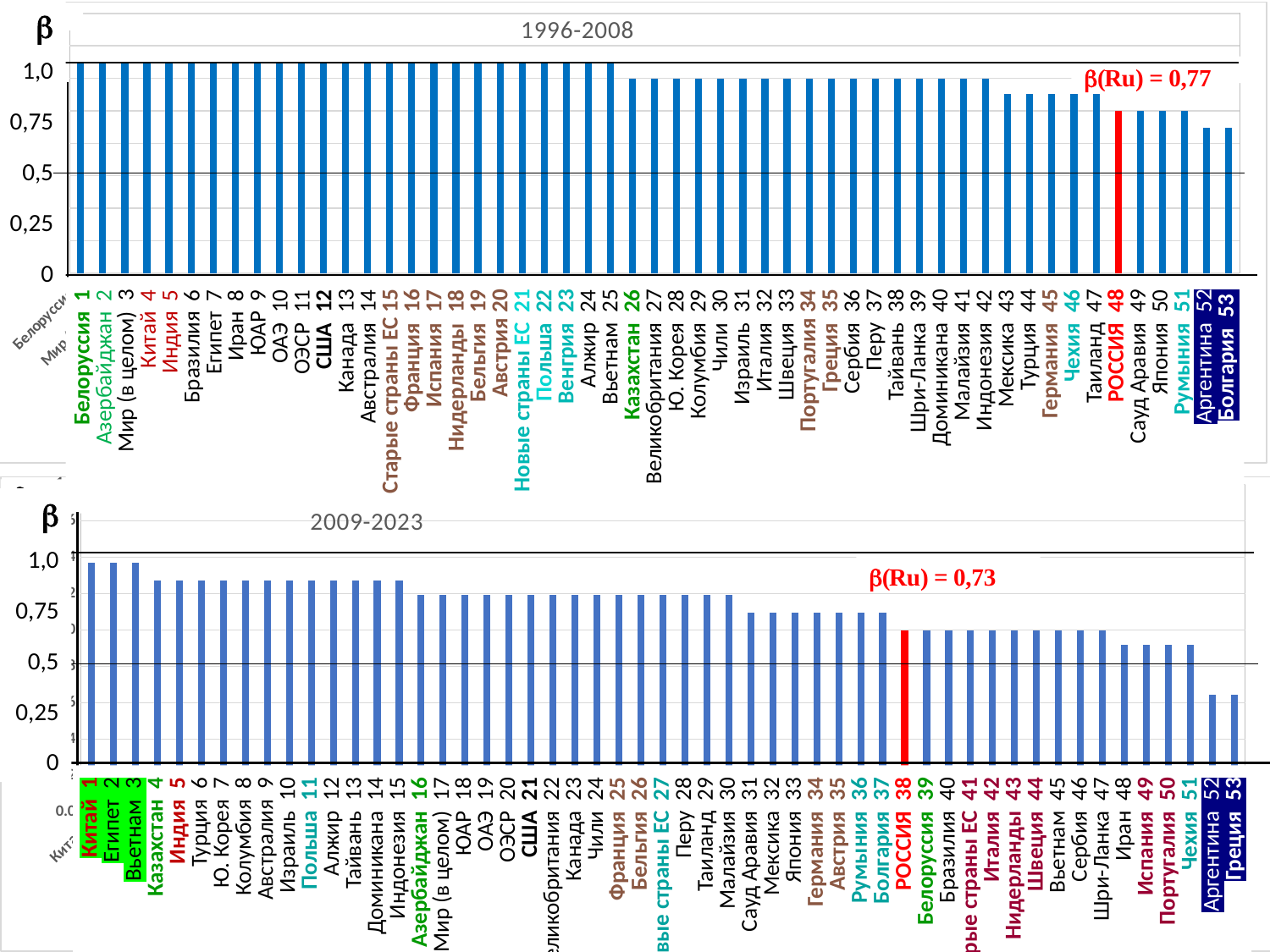
In the 2009-2023 chart, is the value for Аргентина greater or less than 0,5? less What kind of chart is the 1996-2008 chart? bar chart In the 1996-2008 chart, is the value for Белоруссия greater or less than 0,75? greater In the 2009-2023 chart, what colour is the bar for РОССИЯ? red By how much does the printed β(Ru) value in the 1996-2008 chart exceed the printed β(Ru) value in the 2009-2023 chart? 0,04 In the 1996-2008 chart, what rank number is shown next to РОССИЯ on the x axis? 48 In the 1996-2008 chart, what is the value of β(Ru) printed on the chart? 0,77 In the 1996-2008 chart, do the values rise or fall from left to right along the x axis? fall In the 1996-2008 chart, which has the larger value, Белоруссия or Болгария? Белоруссия In the 2009-2023 chart, which has the larger value, Китай or Греция? Китай How many countries/categories are shown in the 2009-2023 chart? 53 In the 2009-2023 chart, what is the value of β(Ru) printed on the chart? 0,73